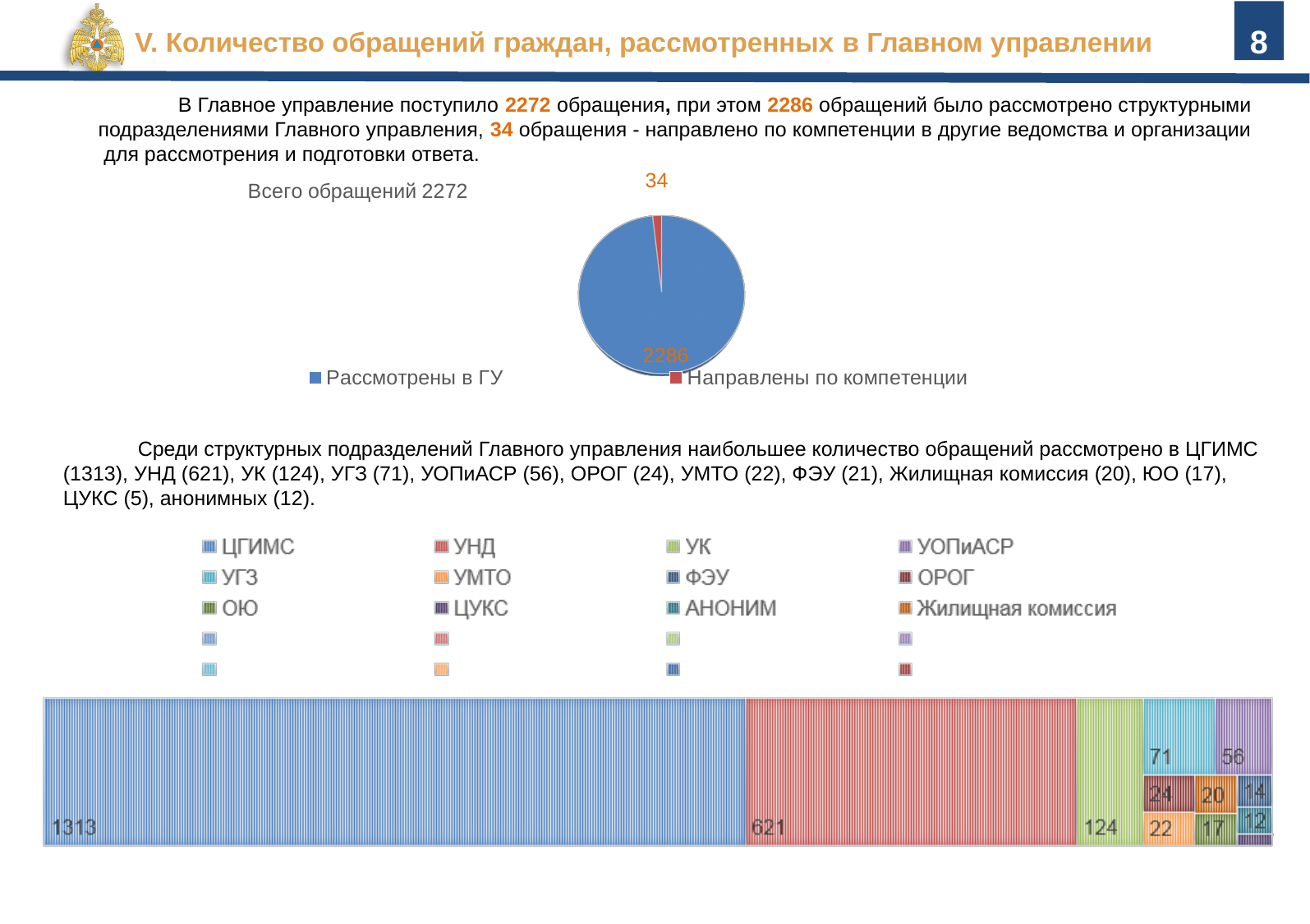
In the pie chart, which slice is the smallest? Направлены по компетенции In the pie chart, what is the difference between the values for 'Рассмотрены в ГУ' and 'Направлены по компетенции'? 2252 In the bottom chart, what value is printed on the red segment? 621 What kind of chart is the top chart on the slide? pie chart What is the title shown above the pie chart? Всего обращений 2272 In the pie chart, how many slices are there? 2 In the pie chart, what value is shown for the slice 'Рассмотрены в ГУ'? 2286 How many entries does the legend of the pie chart list? 2 In the pie chart, what value is shown for the slice 'Направлены по компетенции'? 34 In the pie chart, which slice is the largest? Рассмотрены в ГУ In the bottom chart, what is the largest value printed on a segment? 1313